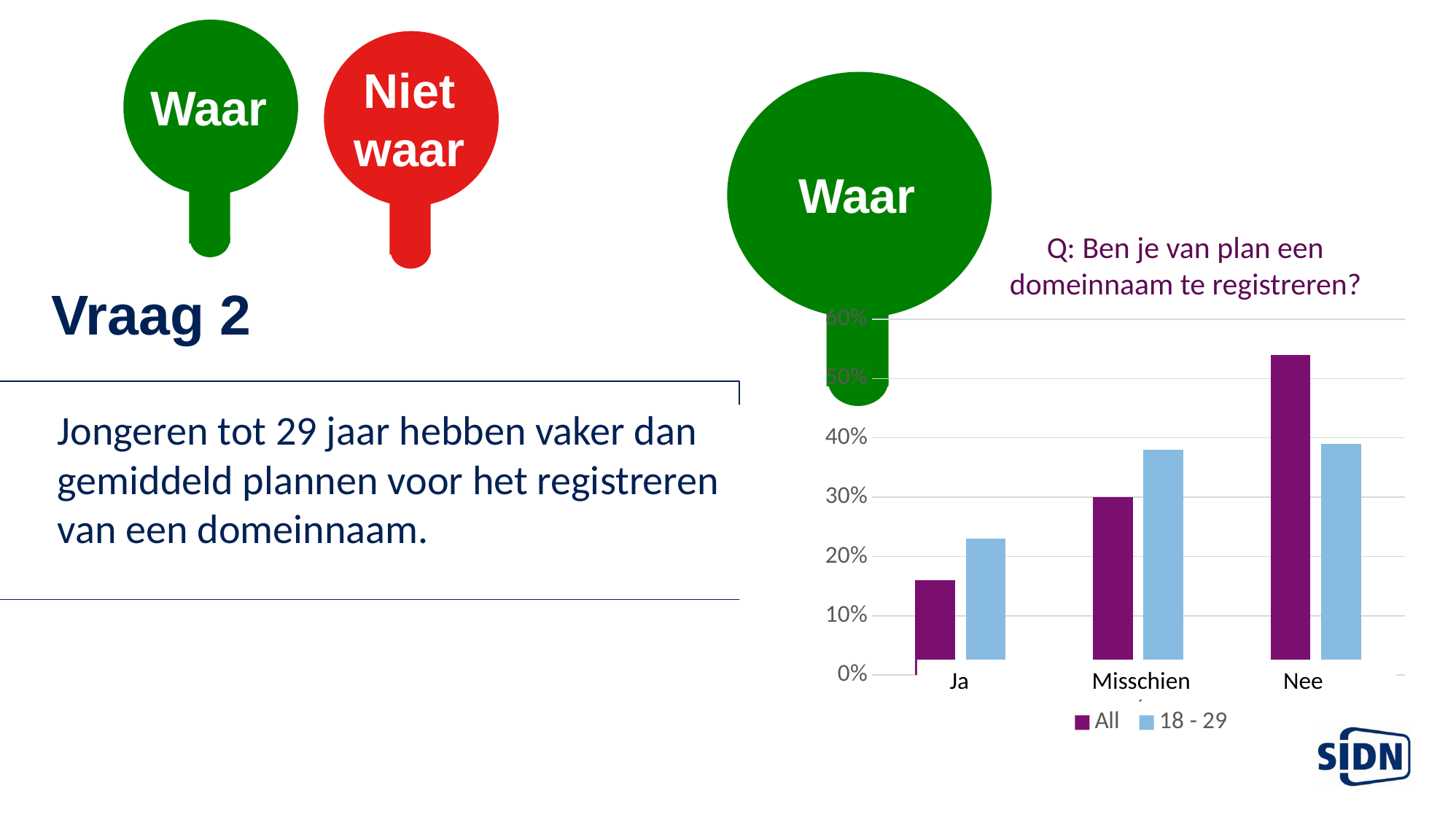
Is the value for Ja in the All series greater or less than 20%? less Which category has the lowest value for the 18 - 29 series? Ja Which category has the lowest value for the All series? Ja Which category has the highest value for the All series? Nee Is the value for Nee in the All series greater or less than 50%? greater For the category Ja, which series has the larger value, All or 18 - 29? 18 - 29 What kind of chart is shown on the slide? bar chart How many categories are shown on the x axis of the chart? 3 How many series does the chart's legend list? 2 For the category Nee, which series has the larger value, All or 18 - 29? All Is the value for Misschien in the 18 - 29 series greater or less than 30%? greater What is the title of the chart? Q: Ben je van plan een domeinnaam te registreren?